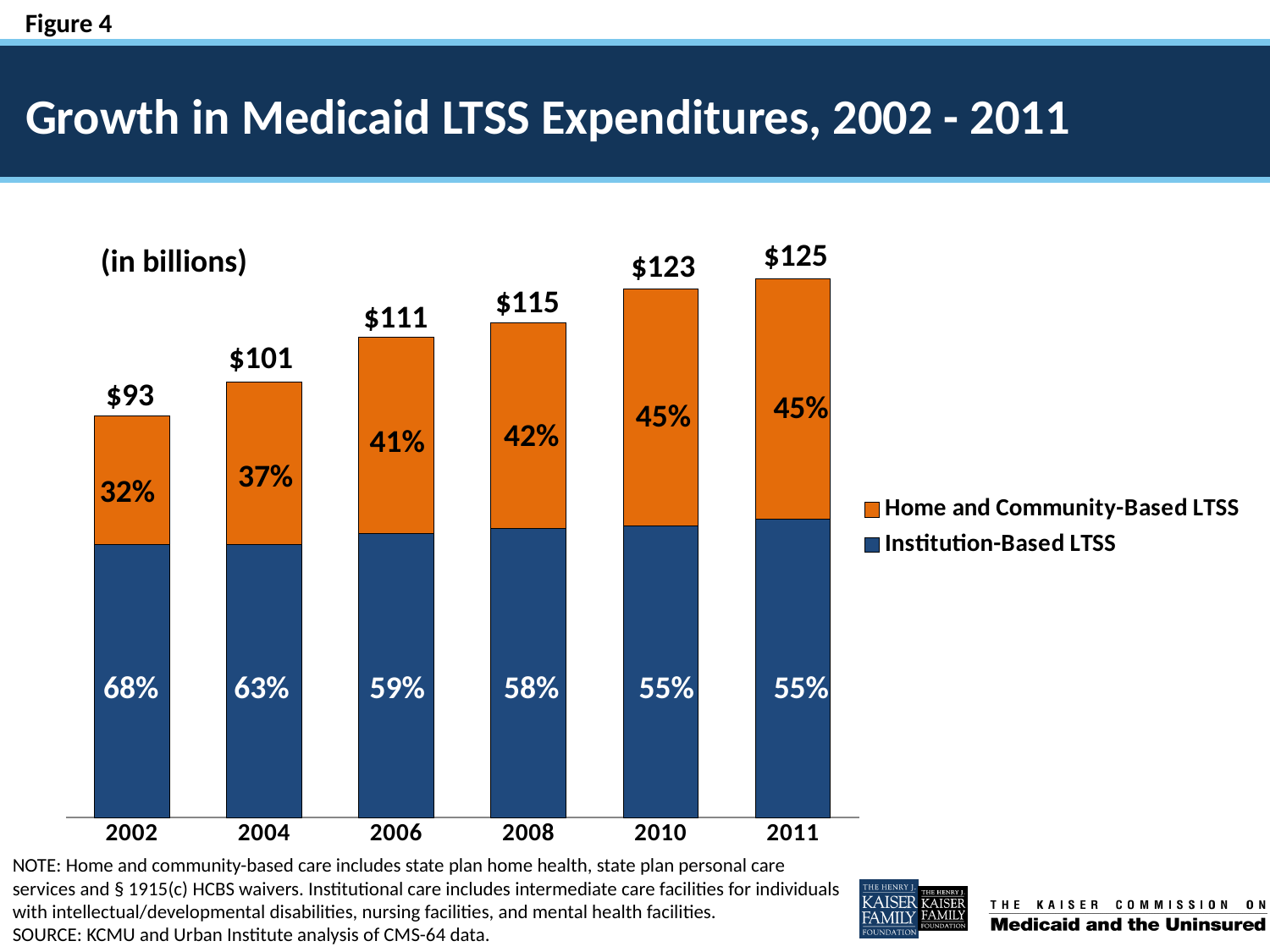
Which year has the highest total LTSS expenditure? 2011 What percentage of LTSS expenditures was Institution-Based LTSS in 2006? 59% What is the difference in total expenditure between 2011 and 2002? $32 Which colour represents Institution-Based LTSS in the chart? Blue Which year has the lowest share for Home and Community-Based LTSS? 2002 What kind of chart is shown on the slide? Stacked bar chart How many years are shown on the x axis? 6 What is the total Medicaid LTSS expenditure shown for 2002? $93 What percentage of LTSS expenditures was Home and Community-Based LTSS in 2010? 45% Which is larger in 2004: the Institution-Based LTSS share or the Home and Community-Based LTSS share? Institution-Based LTSS How many series does the legend list? 2 Does the total LTSS expenditure rise or fall from 2002 to 2011? Rise